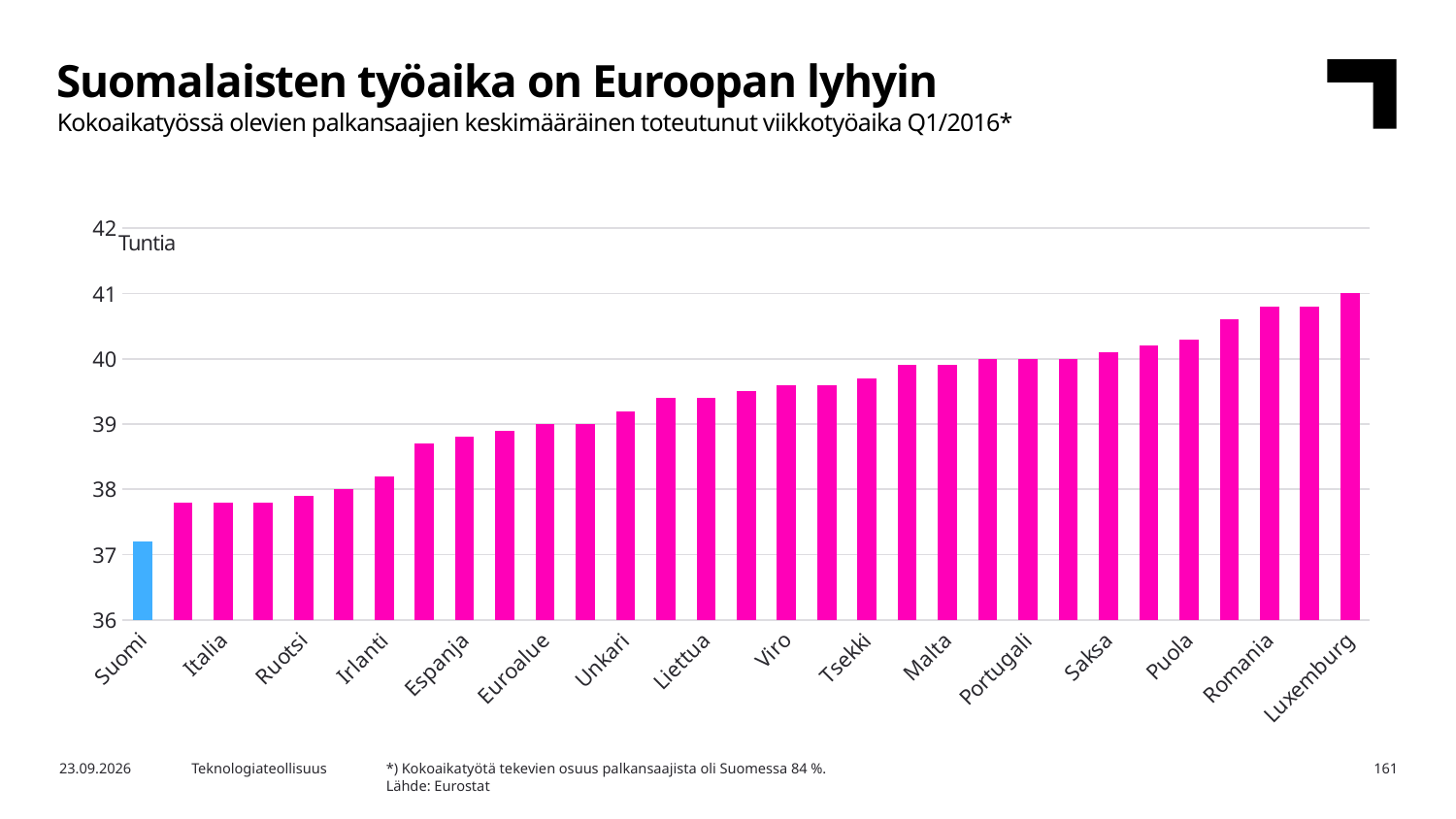
Which country has the highest average weekly working time in the chart? Luxemburg Which country has the lowest average weekly working time in the chart? Suomi What unit label is shown at the top of the vertical axis? Tuntia Which has the larger value, Suomi or Italia? Italia Is the value for Suomi greater or less than 38? less Is the value for Viro greater or less than 39? greater Is the value for Espanja greater or less than 39? less What kind of chart is shown on the slide? bar chart Do the bar values rise or fall from left to right along the x axis? rise